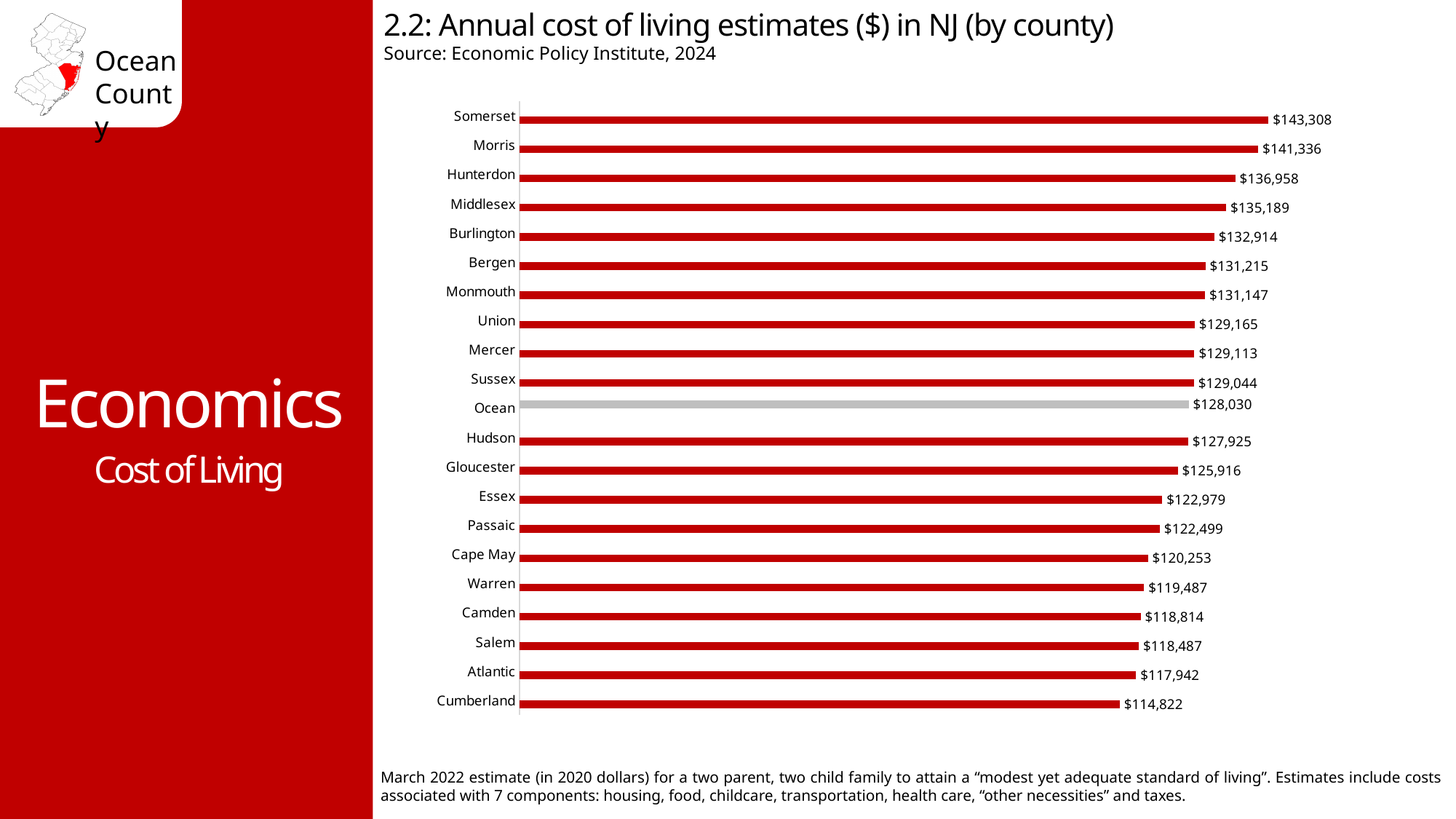
What is the annual cost of living estimate for Hunterdon County? $136,958 What type of chart is used to show the annual cost of living estimates? Bar chart Which county has a higher cost of living estimate, Burlington or Essex? Burlington What is the annual cost of living estimate for Cape May County? $120,253 How many counties are shown in the chart? 21 Which county has the highest annual cost of living estimate? Somerset What is the annual cost of living estimate for Ocean County? $128,030 Which county's bar is shown in grey rather than red? Ocean Which county has a higher cost of living estimate, Gloucester or Warren? Gloucester What is the difference between the cost of living estimates for Somerset and Cumberland counties? $28,486 How much higher is the cost of living estimate for Morris County than for Ocean County? $13,306 Which county has the lowest annual cost of living estimate? Cumberland